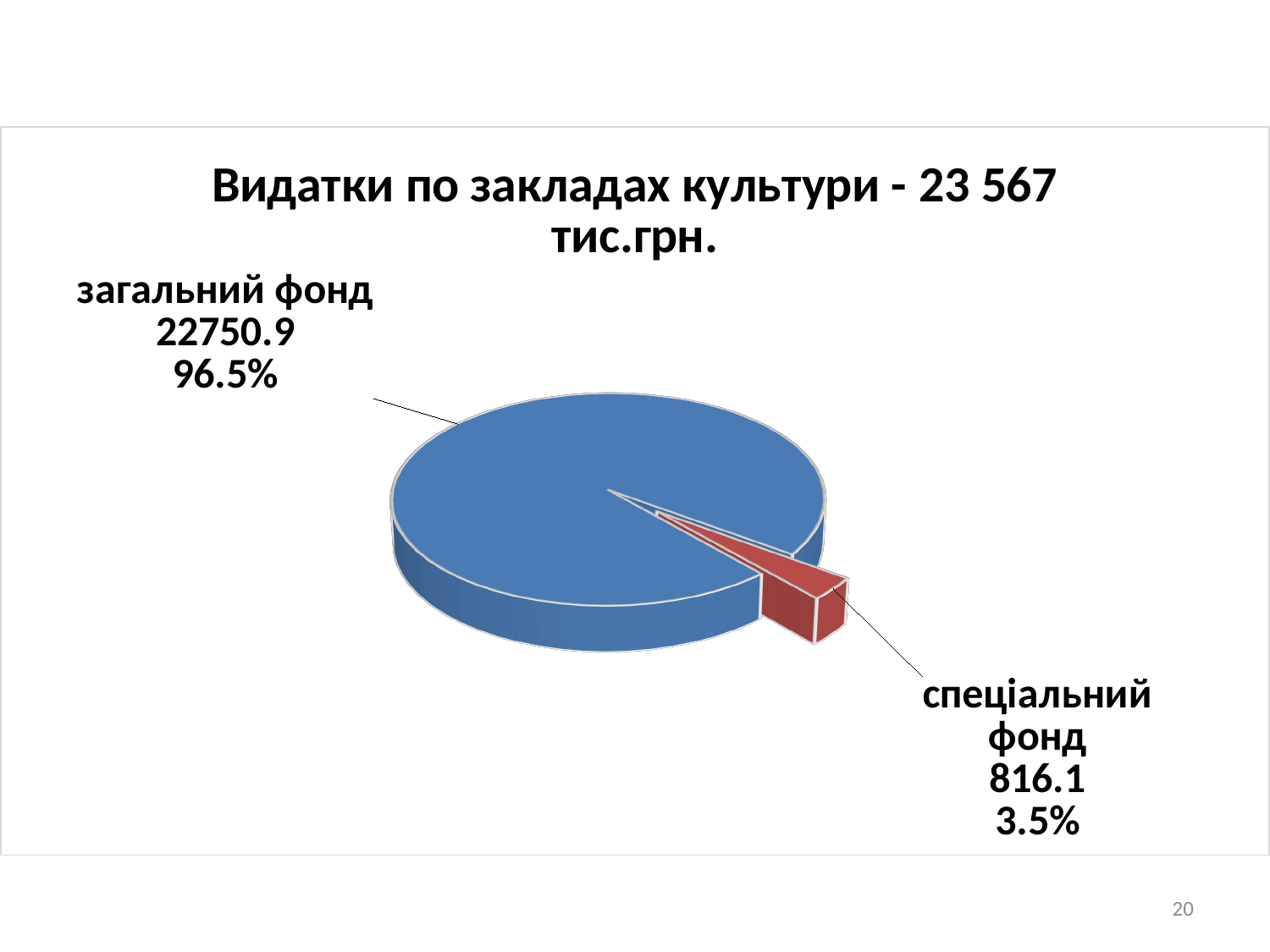
What is the value for загальний фонд? 22750.9 How many slices does the pie chart have? 2 What share of the pie does спеціальний фонд represent? 3.5% What kind of chart is shown on the slide? pie chart Which is larger, загальний фонд or спеціальний фонд? загальний фонд What is the difference between the values for загальний фонд and спеціальний фонд? 21934.8 Which category has the largest slice? загальний фонд What share of the pie does загальний фонд represent? 96.5% Which category has the smallest slice? спеціальний фонд What colour is the slice for спеціальний фонд? red What is the value for спеціальний фонд? 816.1 What is the title of the chart? Видатки по закладах культури - 23 567 тис.грн.